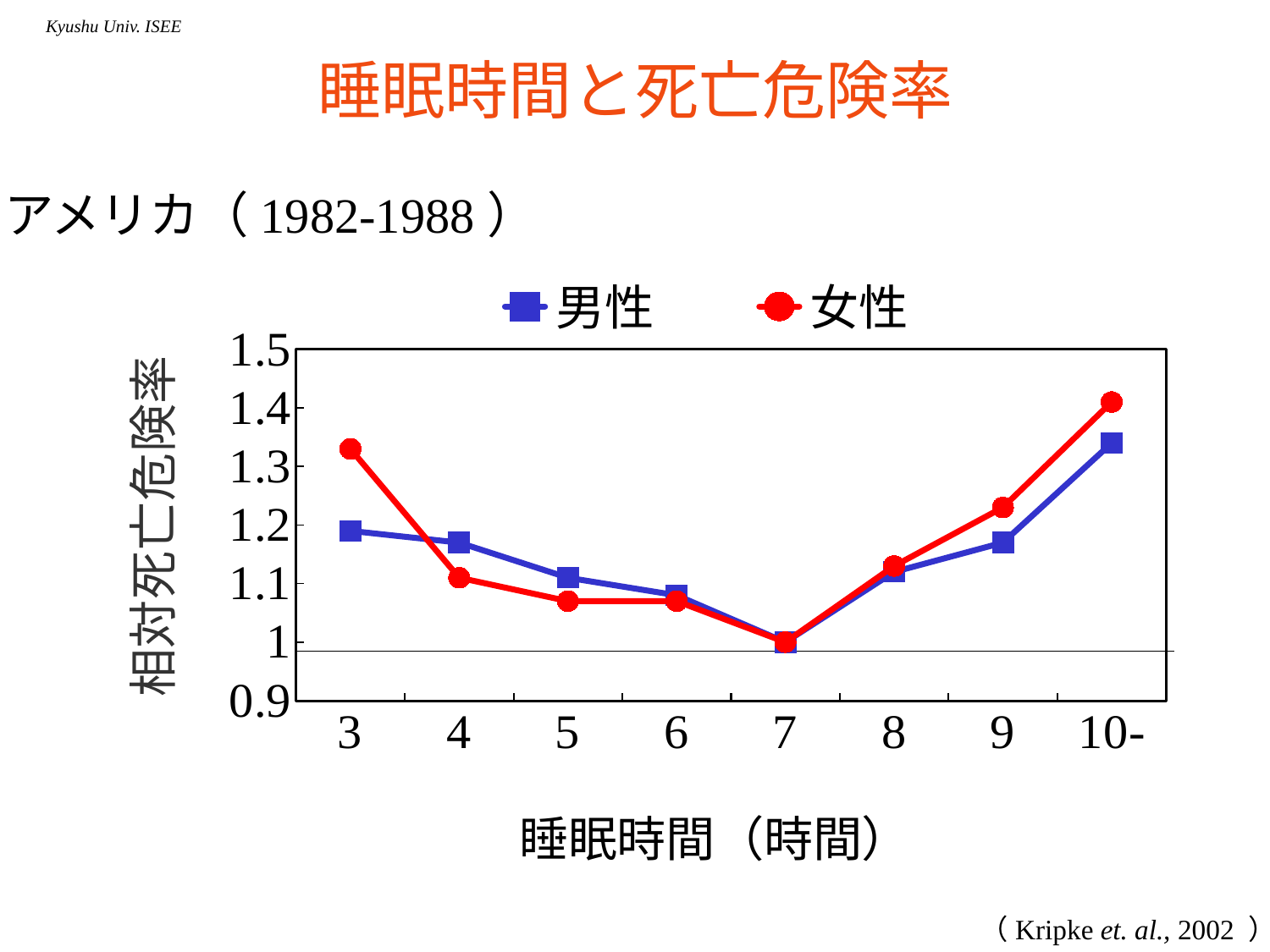
Do the values for 女性 rise or fall from 7 hours to 10- hours? rise How many sleep-duration categories are plotted on the x axis? 8 Is the value for 男性 at 10- hours greater or less than 1.3? greater At 4 hours of sleep, which series has the larger value, 男性 or 女性? 男性 What kind of chart is shown on the slide? line chart Is the value for 女性 at 5 hours greater or less than 1.1? less At which sleep duration is the value for 女性 highest? 10- Is the value for 女性 at 3 hours greater or less than 1.3? greater What is the value for 男性 at 7 hours of sleep? 1 At which sleep duration is the value for 男性 lowest? 7 At 3 hours of sleep, which series has the larger value, 男性 or 女性? 女性 How many series does the legend list? 2